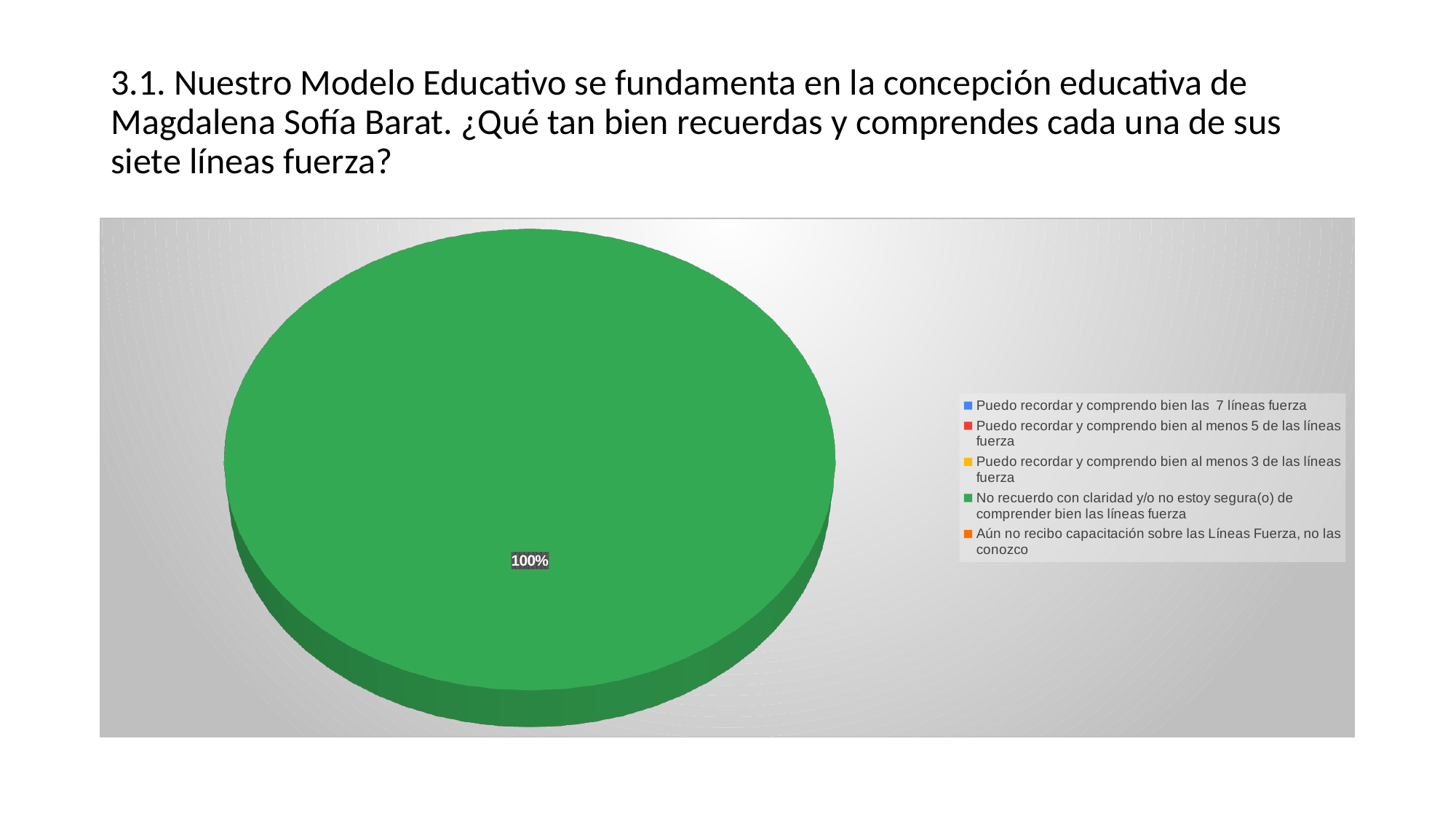
How many slices are visible in the pie chart? 1 What kind of chart is shown on the slide? pie chart Which legend category does the green slice that fills the whole pie correspond to? No recuerdo con claridad y/o no estoy segura(o) de comprender bien las líneas fuerza How many entries does the chart legend list? 5 Which colour is used for the legend entry 'Aún no recibo capacitación sobre las Líneas Fuerza, no las conozco'? orange Which colour is used for the legend entry 'Puedo recordar y comprendo bien las 7 líneas fuerza'? blue What is the value shown on the data label of the pie chart? 100% Which category has the largest share of the pie? No recuerdo con claridad y/o no estoy segura(o) de comprender bien las líneas fuerza Is the share for 'No recuerdo con claridad y/o no estoy segura(o) de comprender bien las líneas fuerza' greater or less than 50%? greater What share of the pie does the green slice represent? 100%